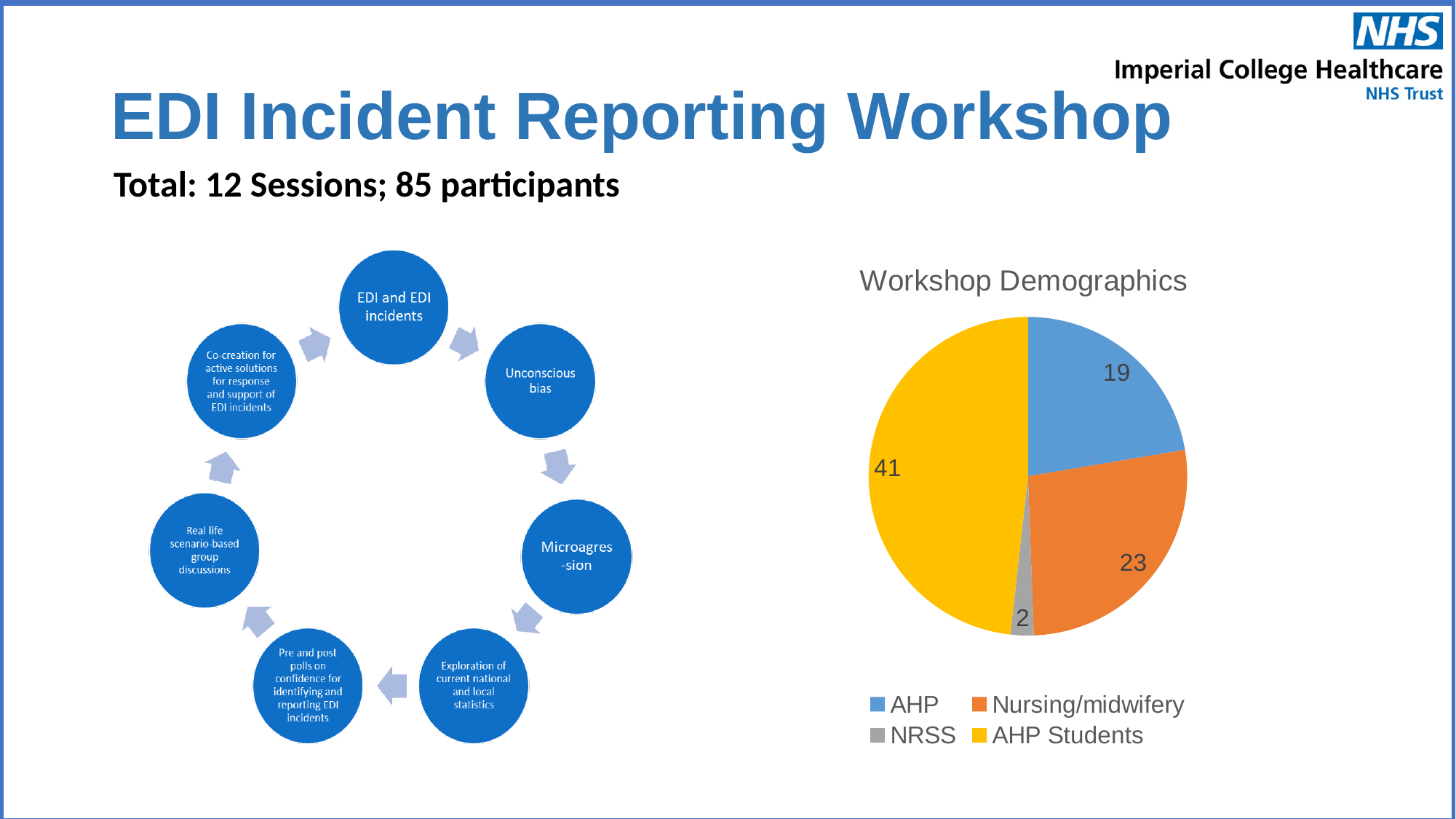
How many categories are shown in the Workshop Demographics pie chart? 4 In the Workshop Demographics pie chart, what is the value for AHP? 19 Which category has the largest slice in the Workshop Demographics pie chart? AHP Students In the Workshop Demographics pie chart, what is the value for AHP Students? 41 In the Workshop Demographics pie chart, which is larger: Nursing/midwifery or AHP? Nursing/midwifery What type of chart is the Workshop Demographics chart? pie chart In the Workshop Demographics pie chart, what is the difference between the AHP Students value and the Nursing/midwifery value? 18 In the Workshop Demographics pie chart, what is the value for Nursing/midwifery? 23 Which category has the smallest slice in the Workshop Demographics pie chart? NRSS What colour is the AHP Students slice in the Workshop Demographics pie chart? yellow What is the total of all slices in the Workshop Demographics pie chart? 85 In the Workshop Demographics pie chart, what is the value for NRSS? 2